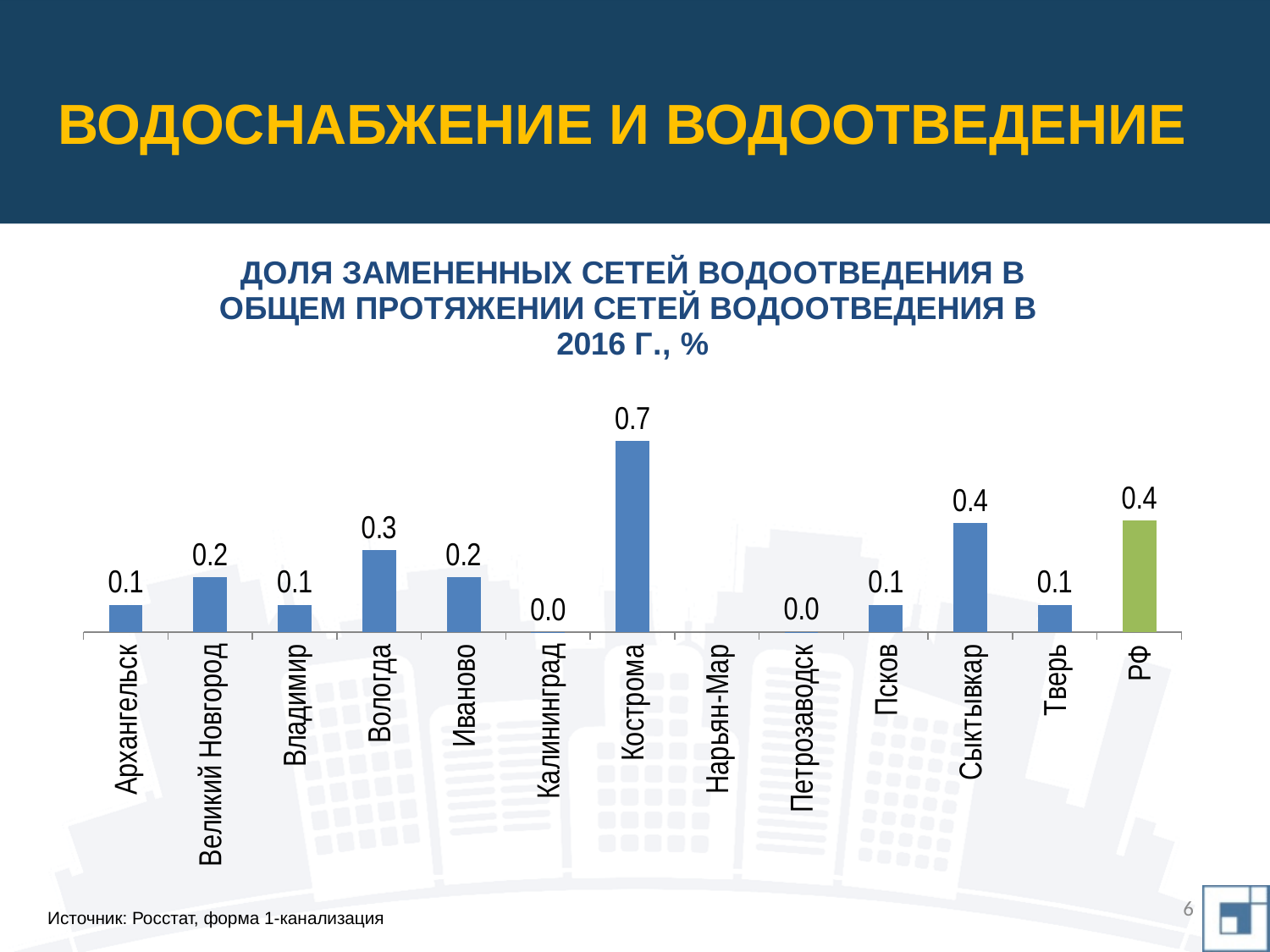
How many categories are shown on the x axis? 13 What is the value for Кострома? 0.7 What kind of chart is this? Bar chart Which is larger, the value for Псков or the value for РФ? РФ Which category has the highest value? Кострома Which is larger, the value for Великий Новгород or the value for Вологда? Вологда What is the value for Калининград? 0.0 What is the value for Сыктывкар? 0.4 What is the difference between the values for Сыктывкар and Тверь? 0.3 What is the difference between the values for Кострома and Вологда? 0.4 What is the value for РФ? 0.4 What is the value for Вологда? 0.3